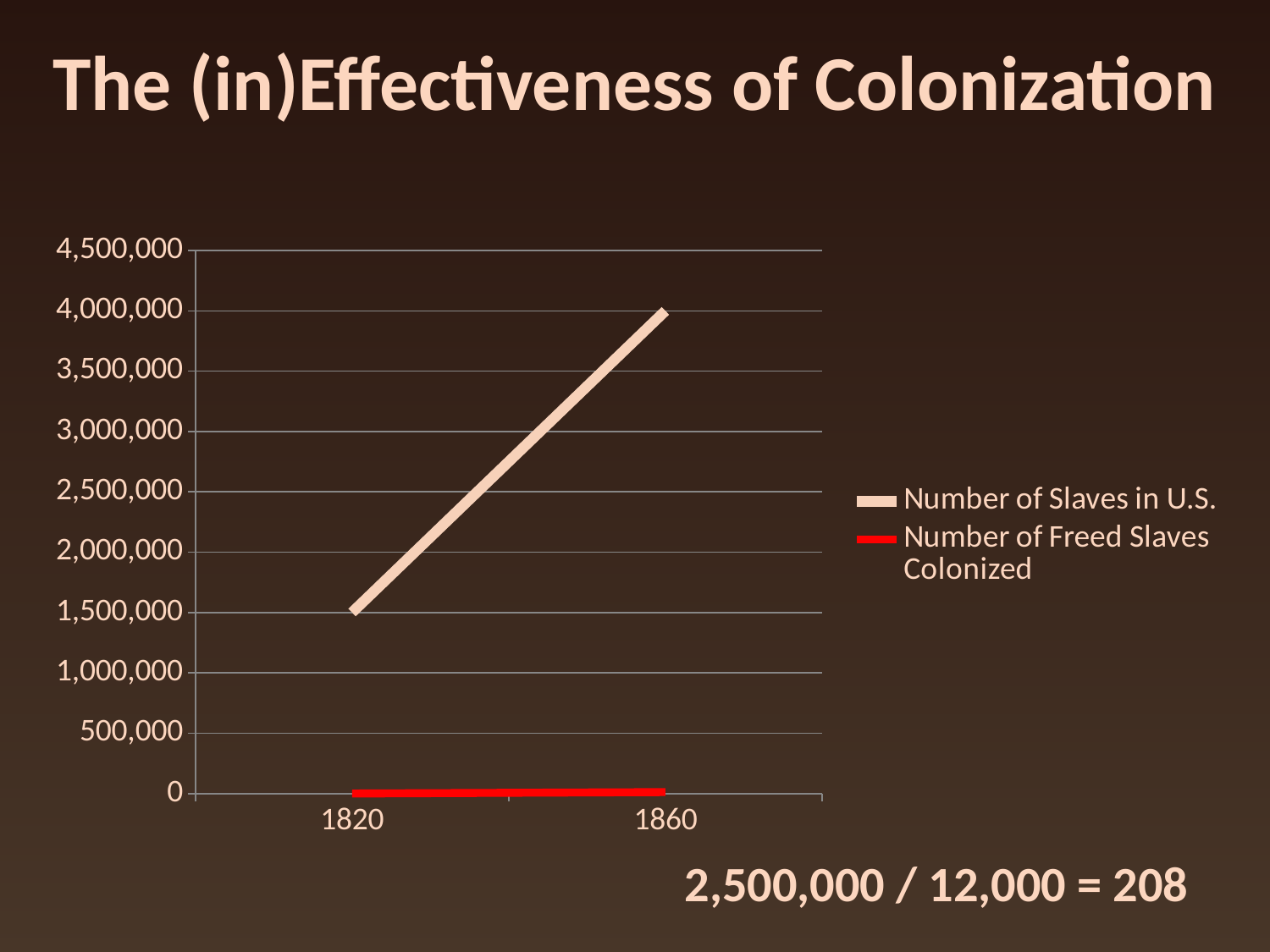
Is the Number of Slaves in U.S. in 1860 greater or less than 3,500,000? greater Which two years are shown on the x axis? 1820 and 1860 Which series has the higher value in 1860, Number of Slaves in U.S. or Number of Freed Slaves Colonized? Number of Slaves in U.S. What kind of chart is shown on the slide? line chart What is the highest value shown on the y axis? 4,500,000 Does the Number of Slaves in U.S. rise or fall from 1820 to 1860? rise Is the Number of Slaves in U.S. in 1820 greater or less than 2,000,000? less Is the Number of Freed Slaves Colonized in 1860 greater or less than 500,000? less What is the title of the slide? The (in)Effectiveness of Colonization In which year is the Number of Slaves in U.S. highest? 1860 How many years are shown on the x axis? 2 How many series does the legend list? 2